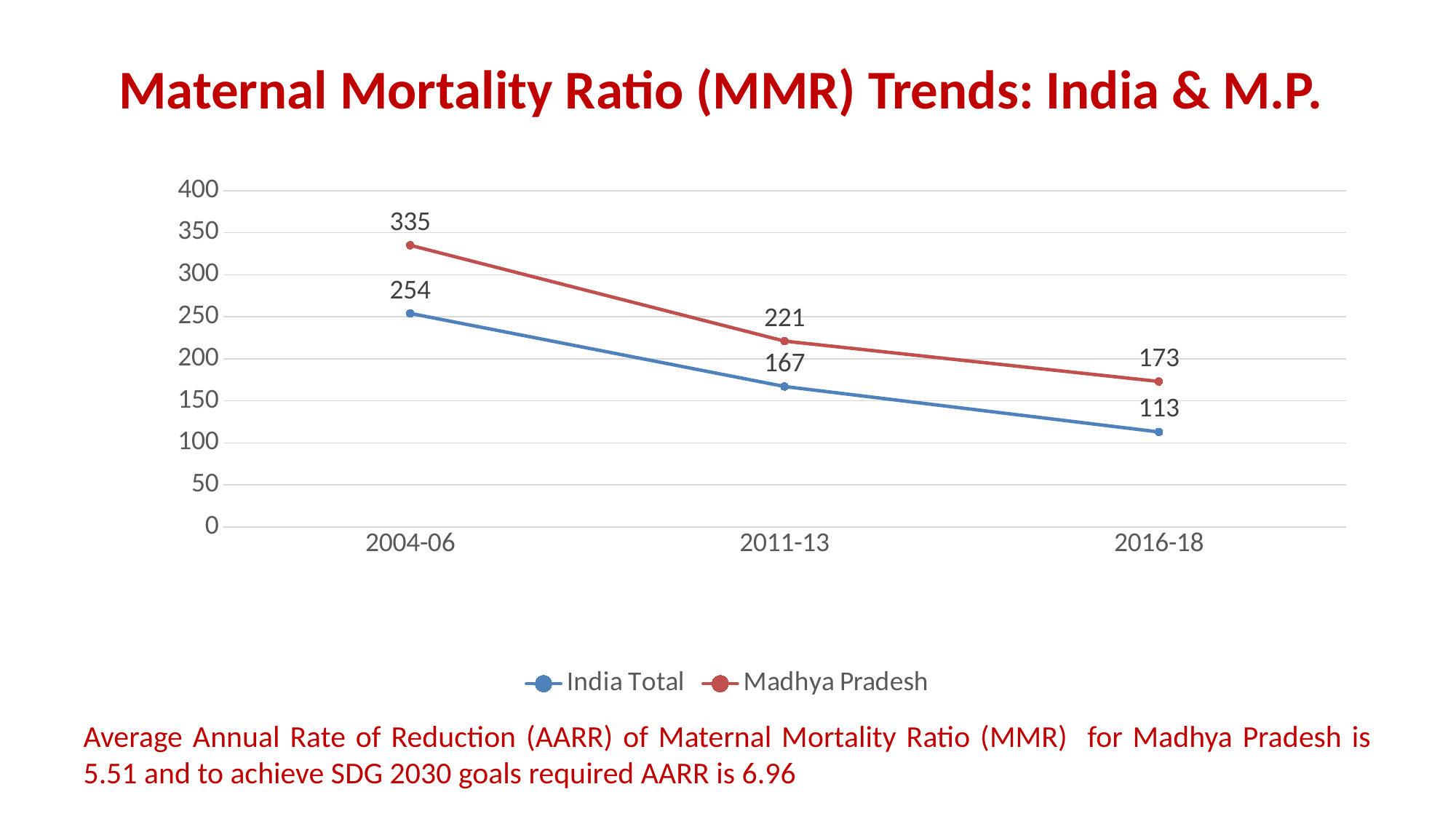
What is the MMR value for India Total in 2016-18? 113 What is the difference between the Madhya Pradesh and India Total MMR values in 2004-06? 81 Which series has the higher MMR in 2011-13, India Total or Madhya Pradesh? Madhya Pradesh In which period is the Madhya Pradesh MMR highest? 2004-06 By how much did the Madhya Pradesh MMR fall from 2011-13 to 2016-18? 48 In which period is the India Total MMR lowest? 2016-18 What kind of chart is shown on the slide? Line chart What is the MMR value for Madhya Pradesh in 2004-06? 335 What is the MMR value for Madhya Pradesh in 2016-18? 173 How many time periods are shown on the x axis? 3 What is the MMR value for India Total in 2011-13? 167 How many series does the legend list? 2